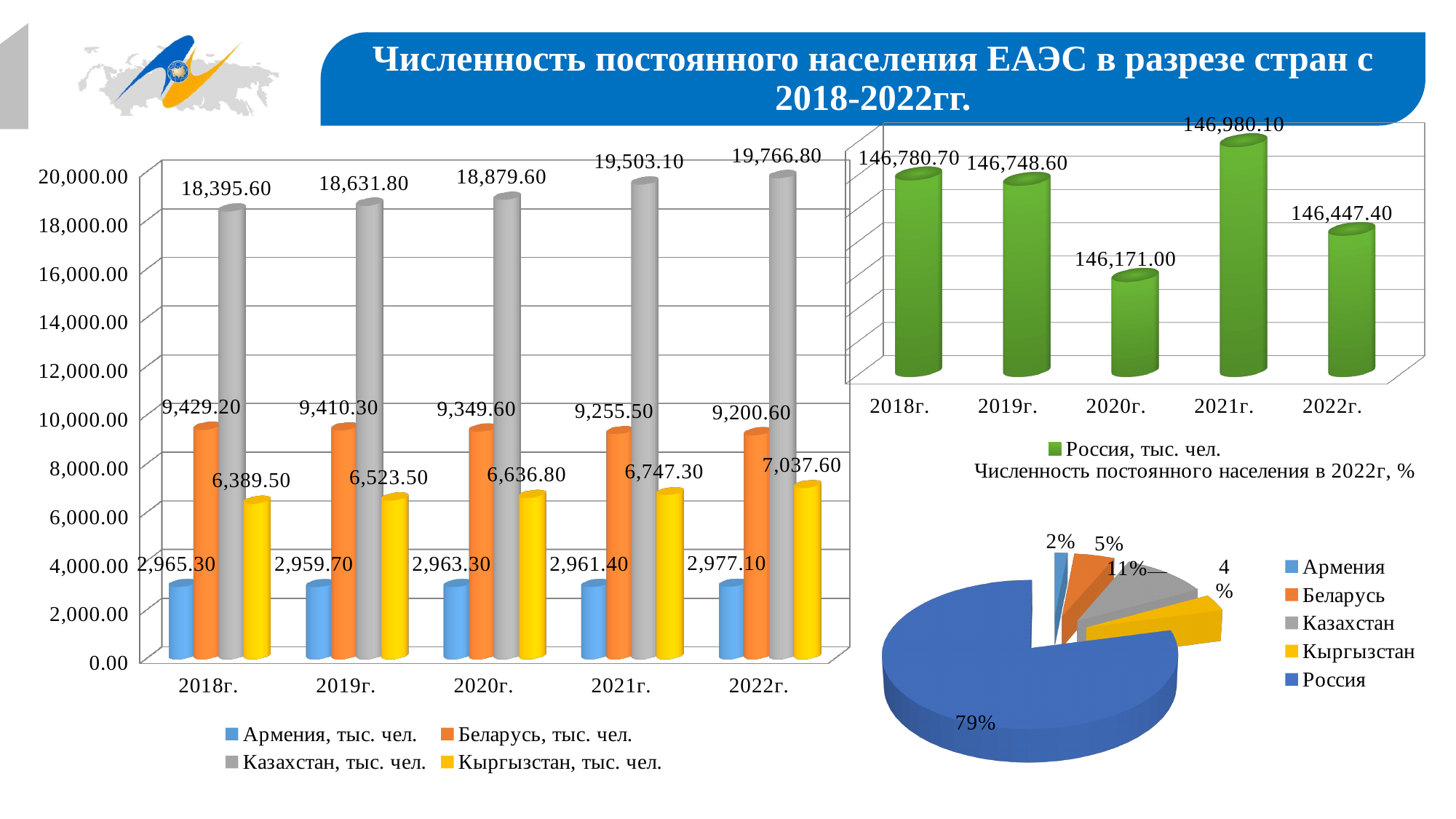
In the left bar chart, what is the difference between the Казахстан values for 2022г. and 2018г.? 1,371.20 In the top-right chart (Россия, тыс. чел.), which year has the lowest value? 2020г. In the pie chart 'Численность постоянного населения в 2022г, %', what share does Россия have? 79% What kind of chart is the bottom-right chart 'Численность постоянного населения в 2022г, %'? pie chart In the left bar chart, what is the value for Беларусь in 2018г.? 9,429.20 In the left bar chart, do the values for Беларусь rise or fall from 2018г. to 2022г.? fall In the top-right chart (Россия, тыс. чел.), how many years are shown? 5 In the left bar chart, how many series does the legend list? 4 In the left bar chart, what is the value for Казахстан in 2022г.? 19,766.80 In the top-right chart (Россия, тыс. чел.), what is the value for 2021г.? 146,980.10 In the left bar chart, what is the value for Кыргызстан in 2020г.? 6,636.80 In the left bar chart, which year has the highest value for Армения? 2022г.